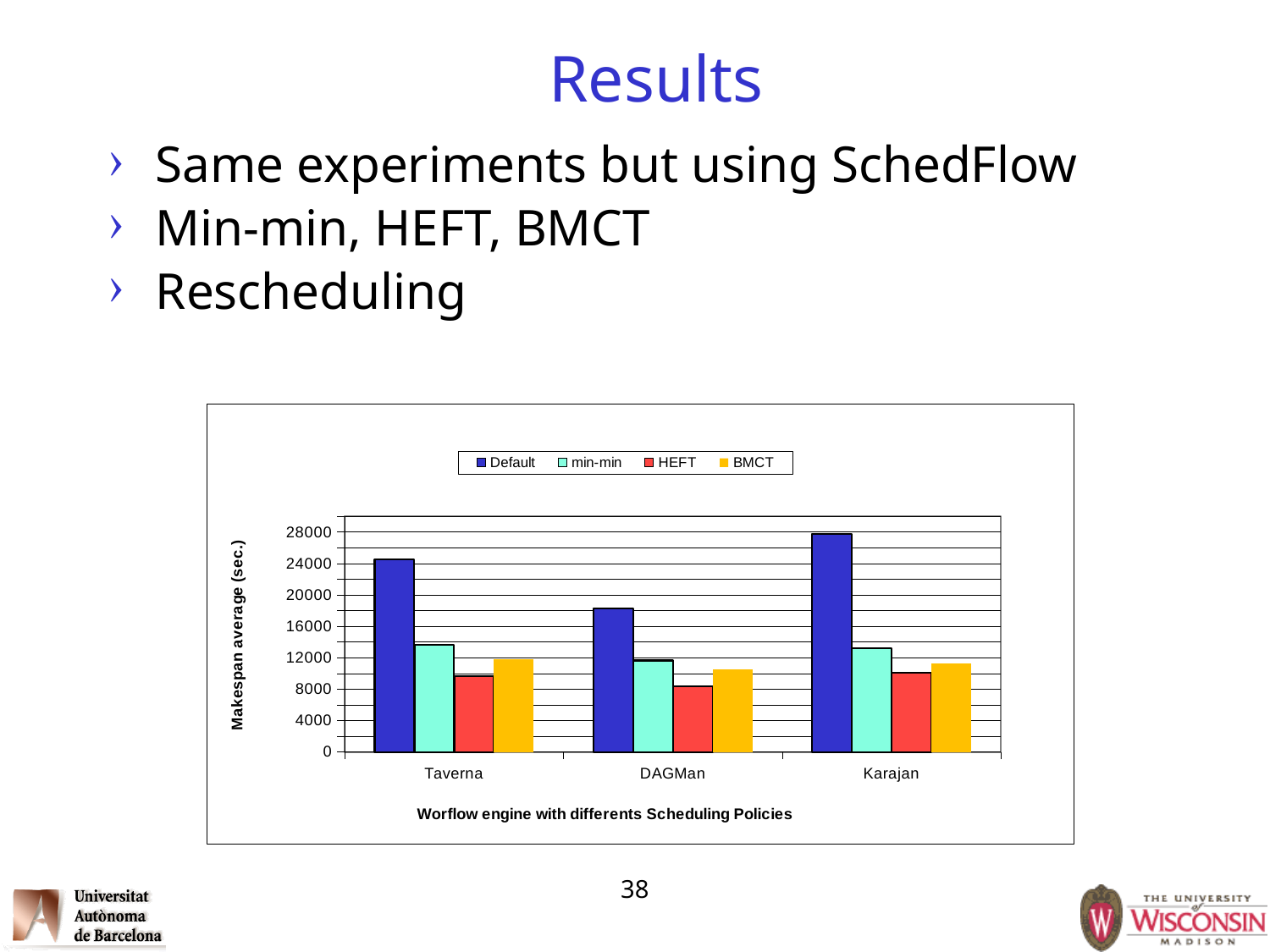
How many series does the legend list? 4 Is the Default makespan average for DAGMan greater or less than 16000? greater Is the HEFT makespan average for DAGMan greater or less than 12000? less What is the label of the y axis? Makespan average (sec.) How many workflow engines are shown on the x axis? 3 Is the min-min makespan average for Taverna greater or less than 12000? greater Which is larger, the Default makespan average for Karajan or for Taverna? Karajan What kind of chart is shown on the slide? bar chart For Taverna, which is larger, the min-min or the BMCT makespan average? min-min Which scheduling policy has the lowest makespan average for DAGMan? HEFT Which workflow engine has the highest Default makespan average? Karajan